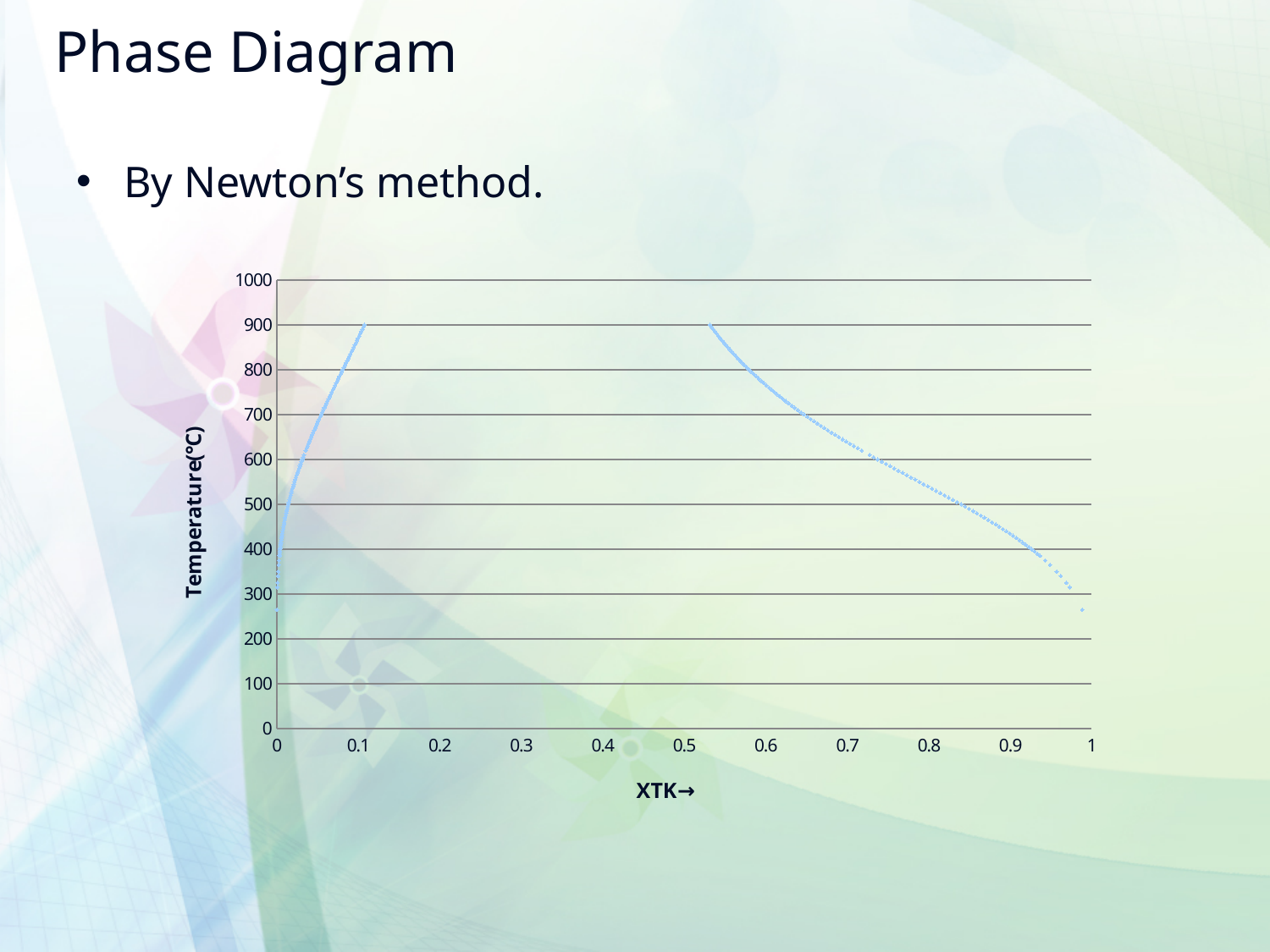
What is the maximum value shown on the vertical axis of the chart? 1000 What is the maximum value shown on the horizontal axis of the chart? 1 How many separate curves of points are plotted in the chart? 2 What is the title of the vertical axis of the chart? Temperature(°C) Along the left-hand curve, does the temperature rise or fall as XTK increases? rise What is the highest temperature reached by the plotted points in the chart? 900 Along the right-hand curve, does the temperature rise or fall as XTK increases? fall Is the temperature of the right-hand curve at XTK = 0.9 greater or less than 500? less What is the title of the horizontal axis of the chart? XTK→ Is the temperature of the left-hand curve at XTK = 0.1 greater or less than 800? greater Is the temperature of the right-hand curve at XTK = 0.6 greater or less than 700? greater What kind of chart is shown on the slide? scatter chart